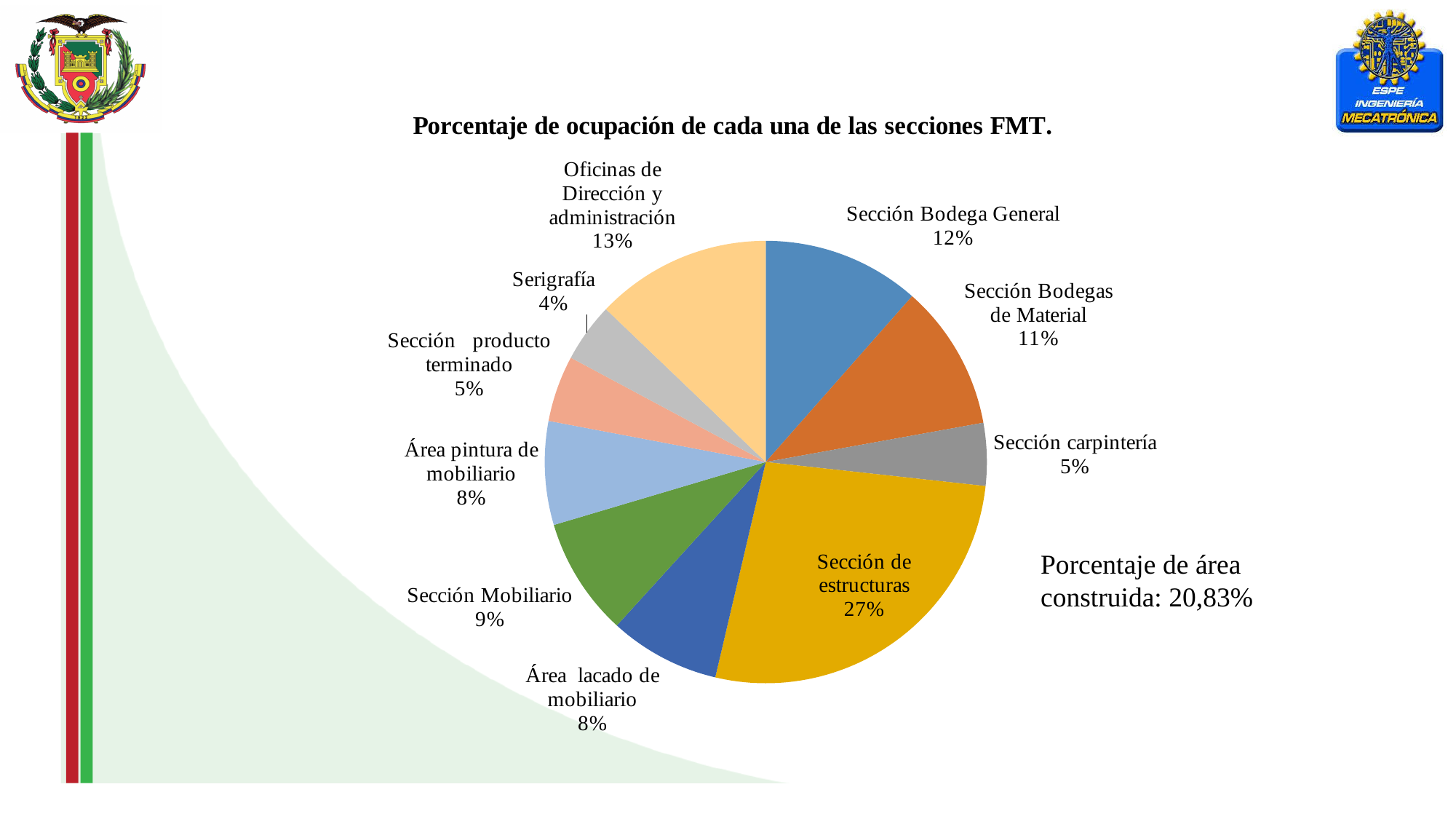
What is the share of Sección carpintería? 5% What is the title of the chart? Porcentaje de ocupación de cada una de las secciones FMT. Which section has the smallest share of the pie? Serigrafía What percentage is shown for Oficinas de Dirección y administración? 13% What percentage is shown for Serigrafía? 4% What type of chart is shown on the slide? pie chart Which has a larger share, Sección Mobiliario or Área pintura de mobiliario? Sección Mobiliario What percentage is shown for Sección Bodegas de Material? 11% Which section has the largest share of the pie? Sección de estructuras How many slices does the pie chart have? 10 What percentage is shown for Sección de estructuras? 27% What is the difference between the shares of Sección de estructuras and Sección Bodega General? 15%